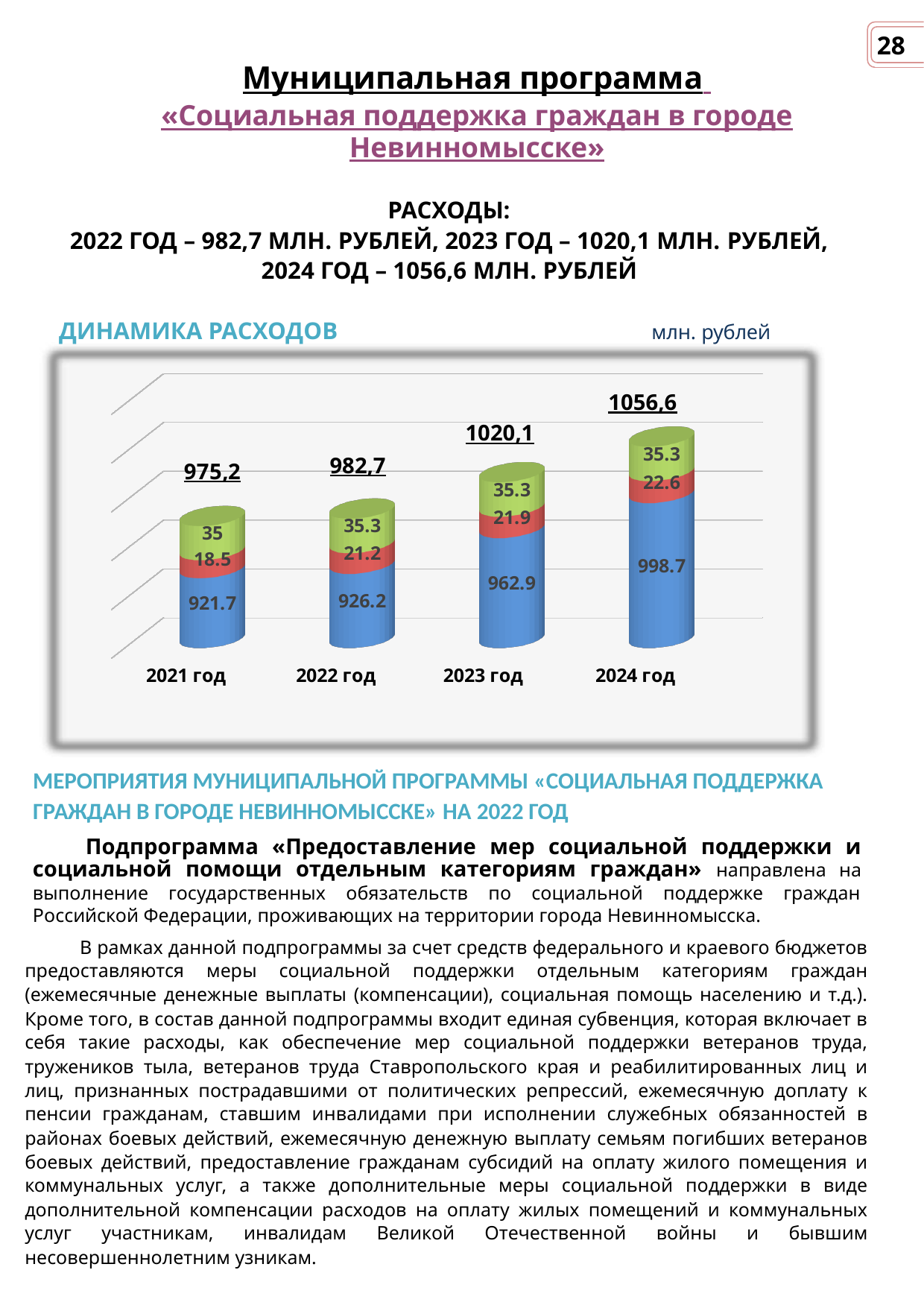
What is the value of the blue (bottom) segment for 2023 год? 962.9 Which year has the lowest total in the «ДИНАМИКА РАСХОДОВ» chart? 2021 год What is the value of the green (top) segment for 2021 год? 35 Do the bar totals rise or fall from 2021 год to 2024 год? Rise What type of chart is shown under the heading «ДИНАМИКА РАСХОДОВ»? Stacked bar chart What is the difference between the total for 2024 год and the total for 2023 год? 36,5 What is the total value printed above the bar for 2024 год? 1056,6 What is the total value printed above the bar for 2021 год? 975,2 How many years (categories) are shown on the x axis of the «ДИНАМИКА РАСХОДОВ» chart? 4 Which year has the highest total in the «ДИНАМИКА РАСХОДОВ» chart? 2024 год What unit is indicated at the top right of the «ДИНАМИКА РАСХОДОВ» chart? млн. рублей What is the value of the red (middle) segment for 2022 год? 21.2